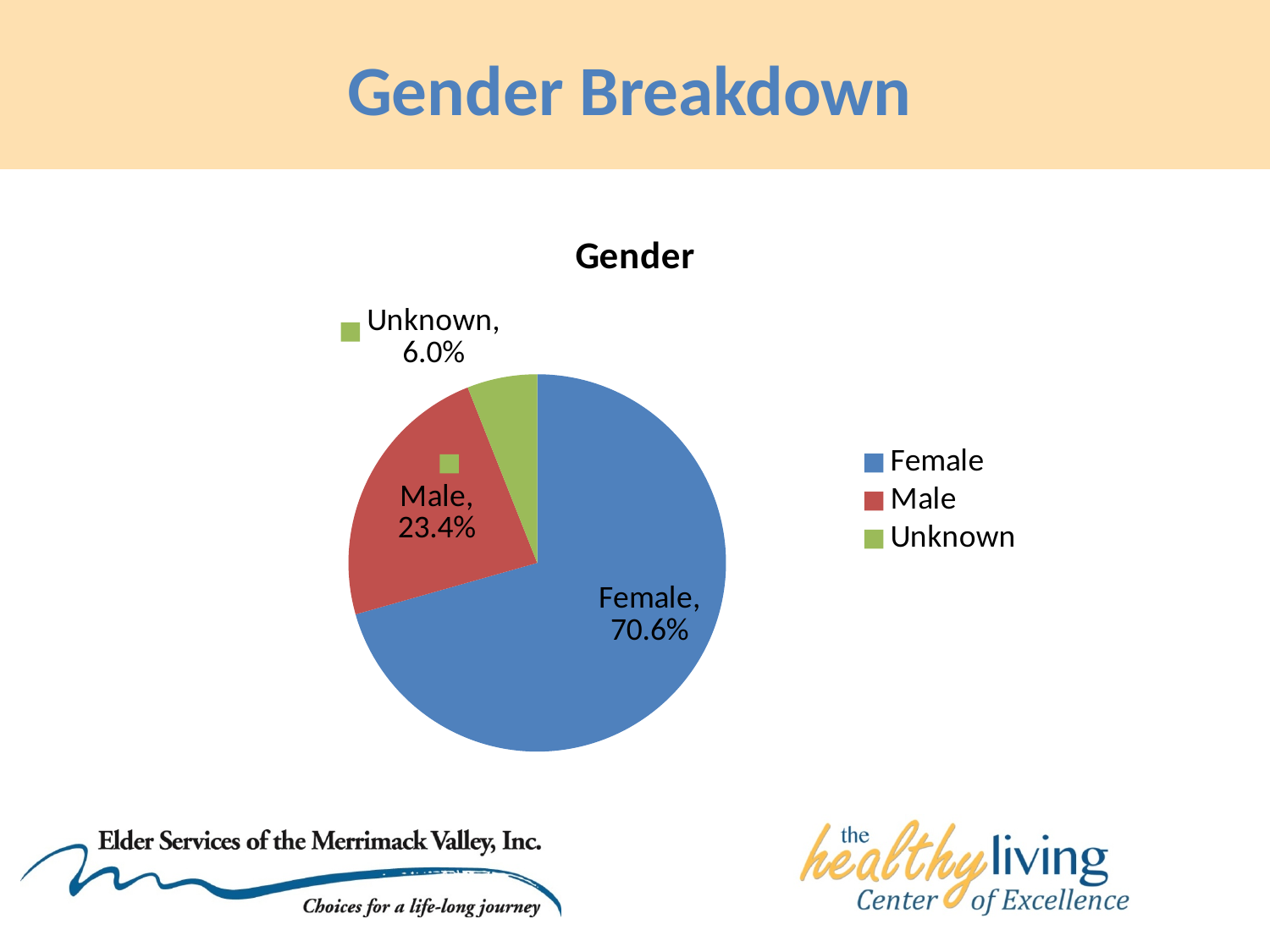
What colour is the Male slice in the pie chart? Red Which share is larger, Male or Unknown? Male Which category has the largest share of the pie chart? Female How many categories are shown in the pie chart? 3 What percentage of the pie chart is Male? 23.4% Which category has the smallest share of the pie chart? Unknown What is the title of the chart? Gender What percentage of the pie chart is Unknown? 6.0% What percentage of the pie chart is Female? 70.6% What is the difference in percentage points between the Male and Unknown shares? 17.4 What is the difference in percentage points between the Female and Male shares? 47.2 What kind of chart is shown on the slide? Pie chart